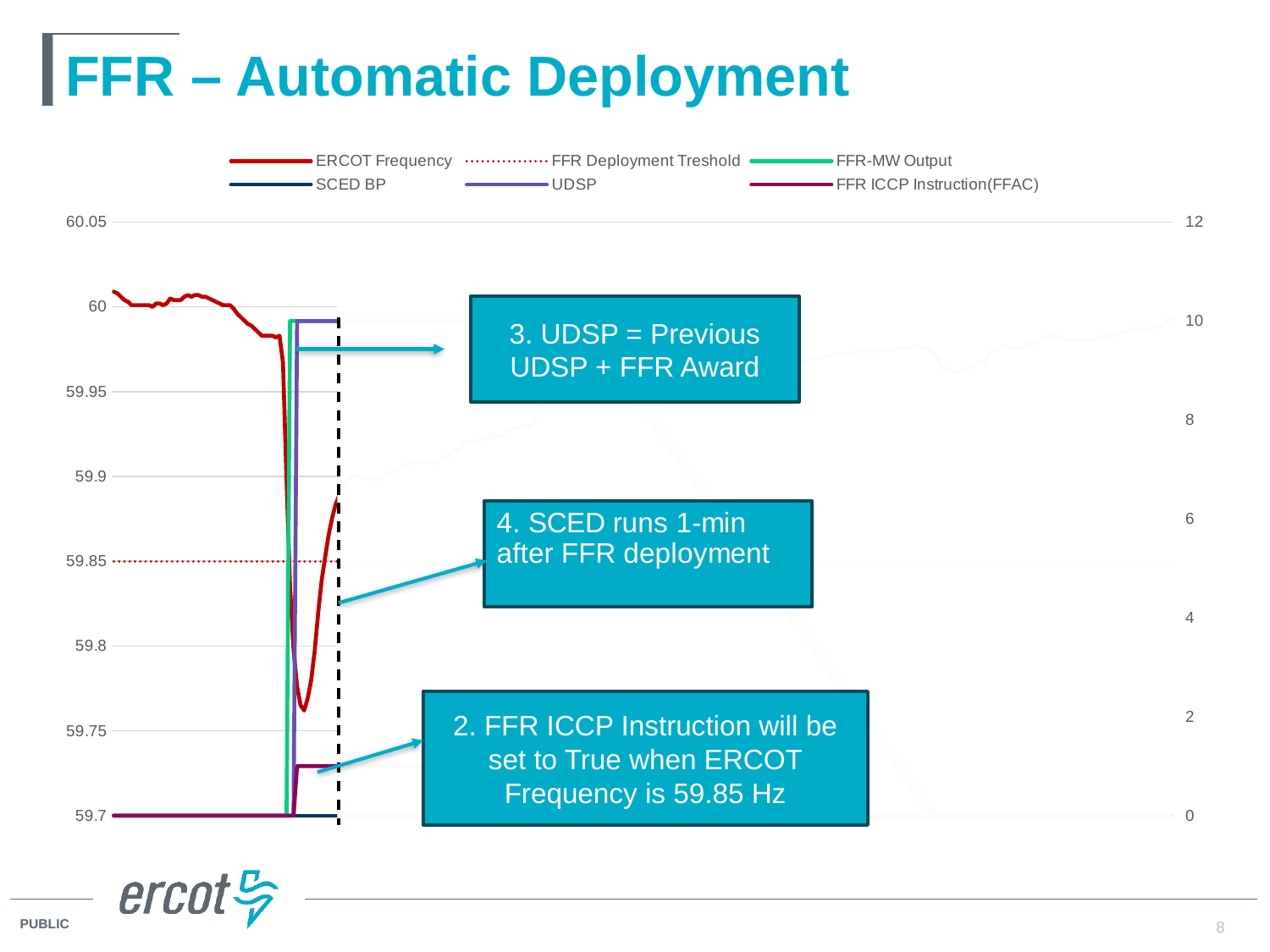
What kind of chart is shown on the slide? line chart After it steps up, is the UDSP line greater or less than 8 on the right-hand axis? greater Which series is drawn as a dotted line in the legend? FFR Deployment Treshold Does the ERCOT Frequency line rise or fall from the start of the chart to its lowest point? fall After the deployment step, which is higher on the right-hand axis: UDSP or FFR ICCP Instruction(FFAC)? UDSP How many series does the legend list? 6 Does the ERCOT Frequency line rise or fall after reaching its lowest point? rise Is the lowest point of the ERCOT Frequency line greater or less than 59.8? less What is the highest value shown on the right-hand axis? 12 At what frequency value does the FFR Deployment Treshold line sit on the left axis? 59.85 After it steps up, is the FFR ICCP Instruction(FFAC) line greater or less than 2 on the right-hand axis? less